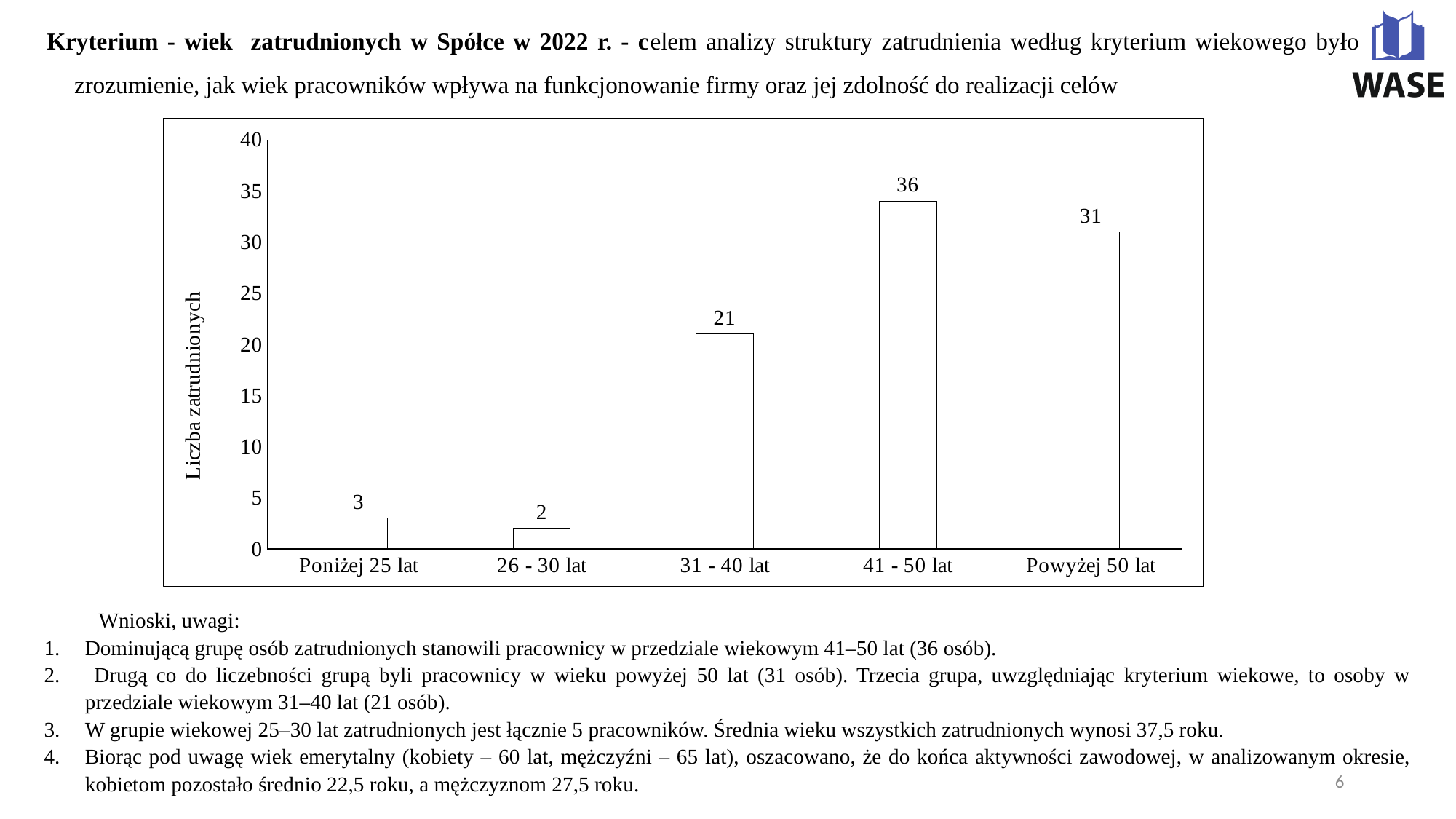
What kind of chart is shown on the slide? bar chart How many age categories are shown on the x axis? 5 What is the total of the values for Poniżej 25 lat and 26 - 30 lat? 5 Is the value for 31 - 40 lat greater or less than 25? less What is the difference between the values for 41 - 50 lat and Powyżej 50 lat? 5 Which is larger: the value for 31 - 40 lat or the value for Powyżej 50 lat? Powyżej 50 lat What is the value for the Poniżej 25 lat category? 3 Which age group has the highest number of employees? 41 - 50 lat How many employees are in the 41 - 50 lat age group? 36 What is the value for the 26 - 30 lat category? 2 Which age group has the lowest number of employees? 26 - 30 lat What is the label of the vertical axis? Liczba zatrudnionych